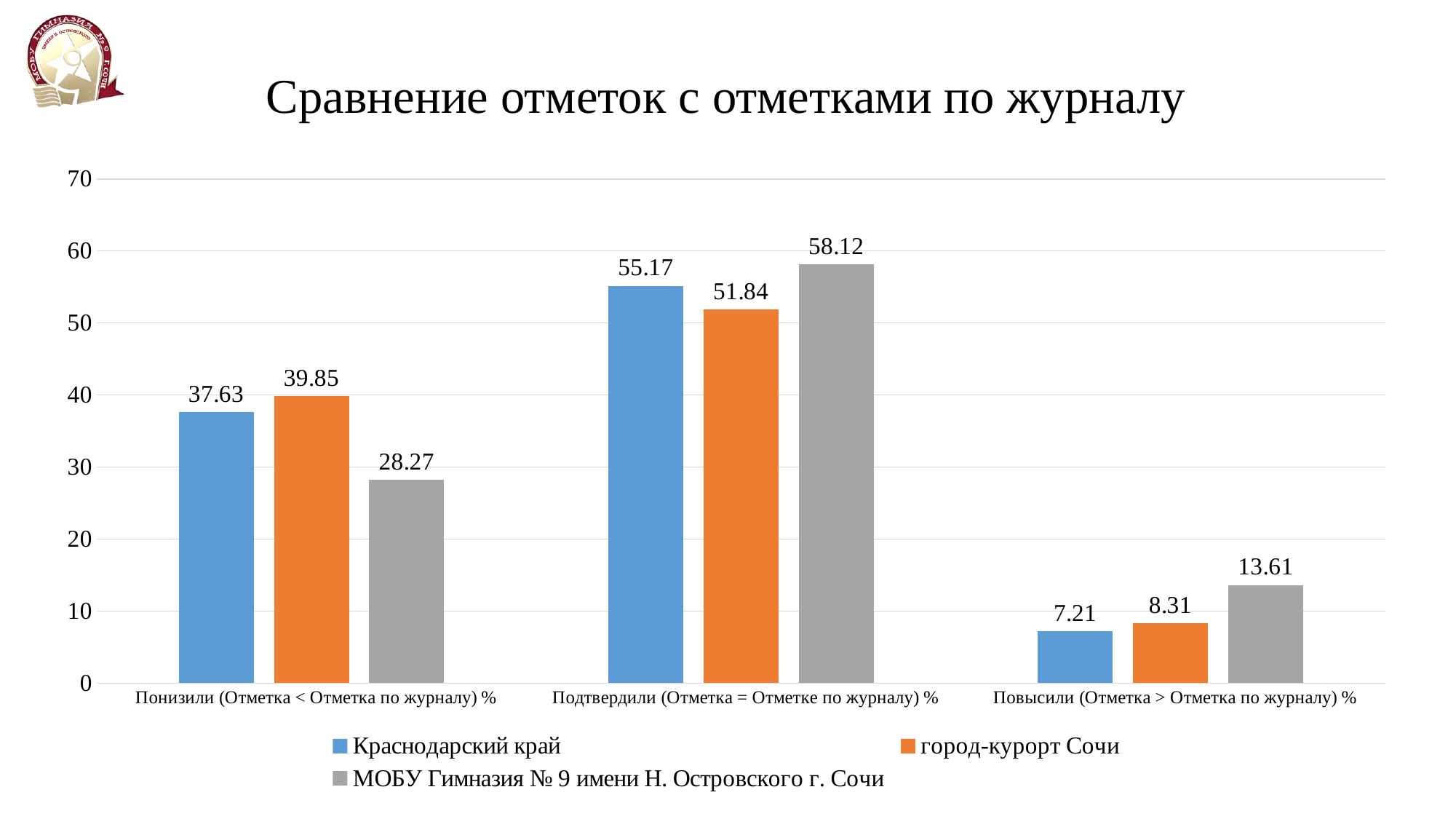
Is the value for город-курорт Сочи in the Подтвердили category greater or less than 50? greater Which series has the highest value in the Подтвердили category? МОБУ Гимназия № 9 имени Н. Островского г. Сочи How many categories are shown on the x axis? 3 What is the value for город-курорт Сочи in the Повысили category? 8.31 What is the title of the chart? Сравнение отметок с отметками по журналу What kind of chart is shown on the slide? bar chart What is the value for Краснодарский край in the Понизили category? 37.63 How many series does the legend list? 3 Which series has the lowest value in the Понизили category? МОБУ Гимназия № 9 имени Н. Островского г. Сочи Which is larger in the Повысили category: Краснодарский край or МОБУ Гимназия № 9? МОБУ Гимназия № 9 имени Н. Островского г. Сочи What is the difference between город-курорт Сочи and Краснодарский край in the Понизили category? 2.22 What is the value for МОБУ Гимназия № 9 имени Н. Островского г. Сочи in the Подтвердили category? 58.12